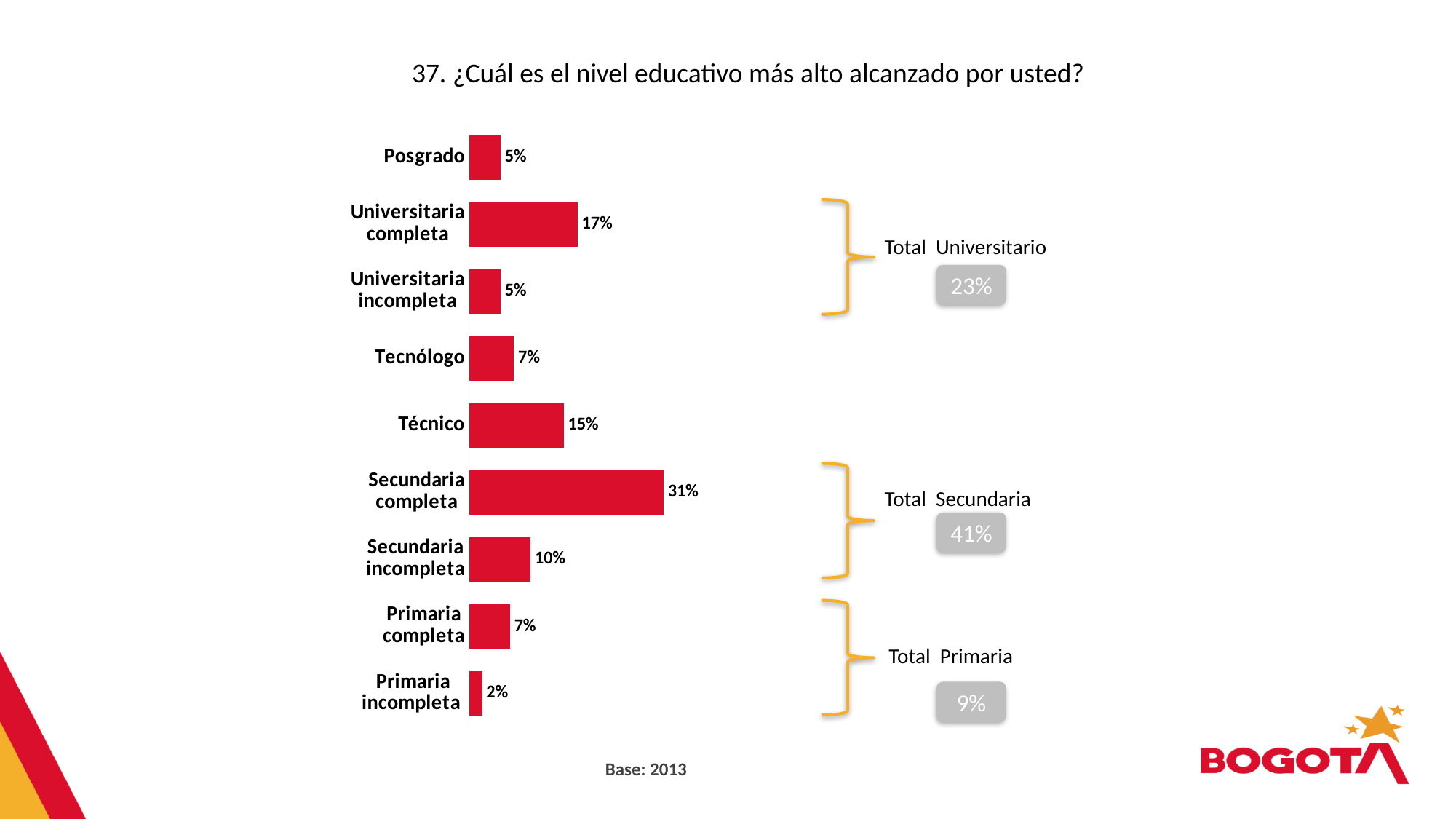
What is the value for Universitaria completa? 17% What kind of chart is shown on the slide? Bar chart What is the base shown below the chart? 2013 What is the value for Secundaria completa? 31% What is the Total Secundaria value shown next to the chart? 41% How many categories are shown in the chart? 9 Which is larger, Técnico or Tecnólogo? Técnico Which category has the highest value? Secundaria completa What is the value for Técnico? 15% What is the difference between Secundaria completa and Secundaria incompleta? 21% What is the value for Primaria incompleta? 2% Which category has the lowest value? Primaria incompleta